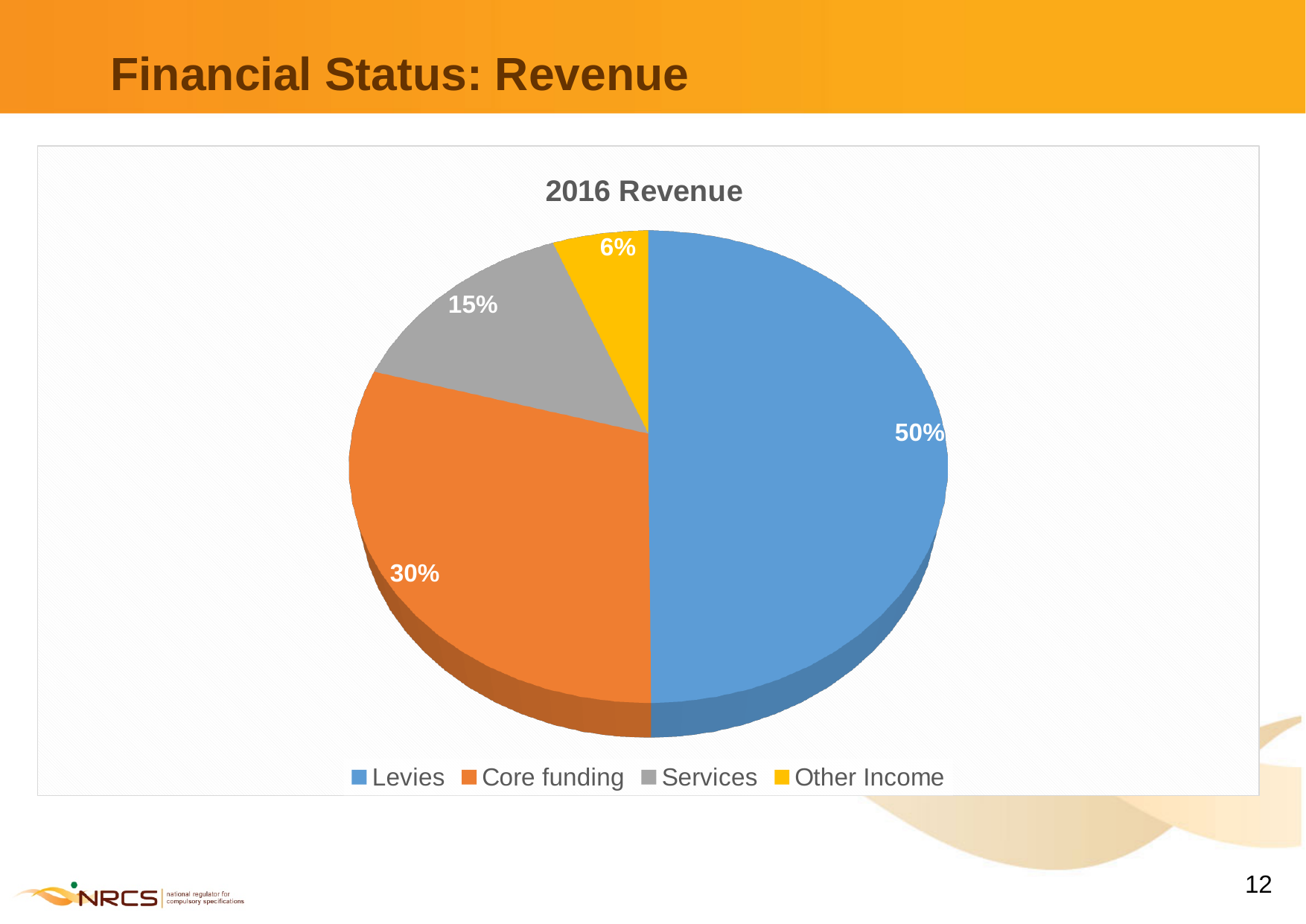
What share of 2016 Revenue comes from Levies? 50% How many revenue categories are shown in the pie chart? 4 Which revenue source has the largest share of 2016 Revenue? Levies What share of 2016 Revenue comes from Core funding? 30% What share of 2016 Revenue comes from Other Income? 6% Which revenue source has the smallest share of 2016 Revenue? Other Income What is the title of the chart? 2016 Revenue What is the difference in percentage points between the Services share and the Other Income share? 9 percentage points Which has a larger share of 2016 Revenue, Core funding or Services? Core funding What kind of chart is shown on the slide? Pie chart What is the difference in percentage points between the Levies share and the Core funding share? 20 percentage points